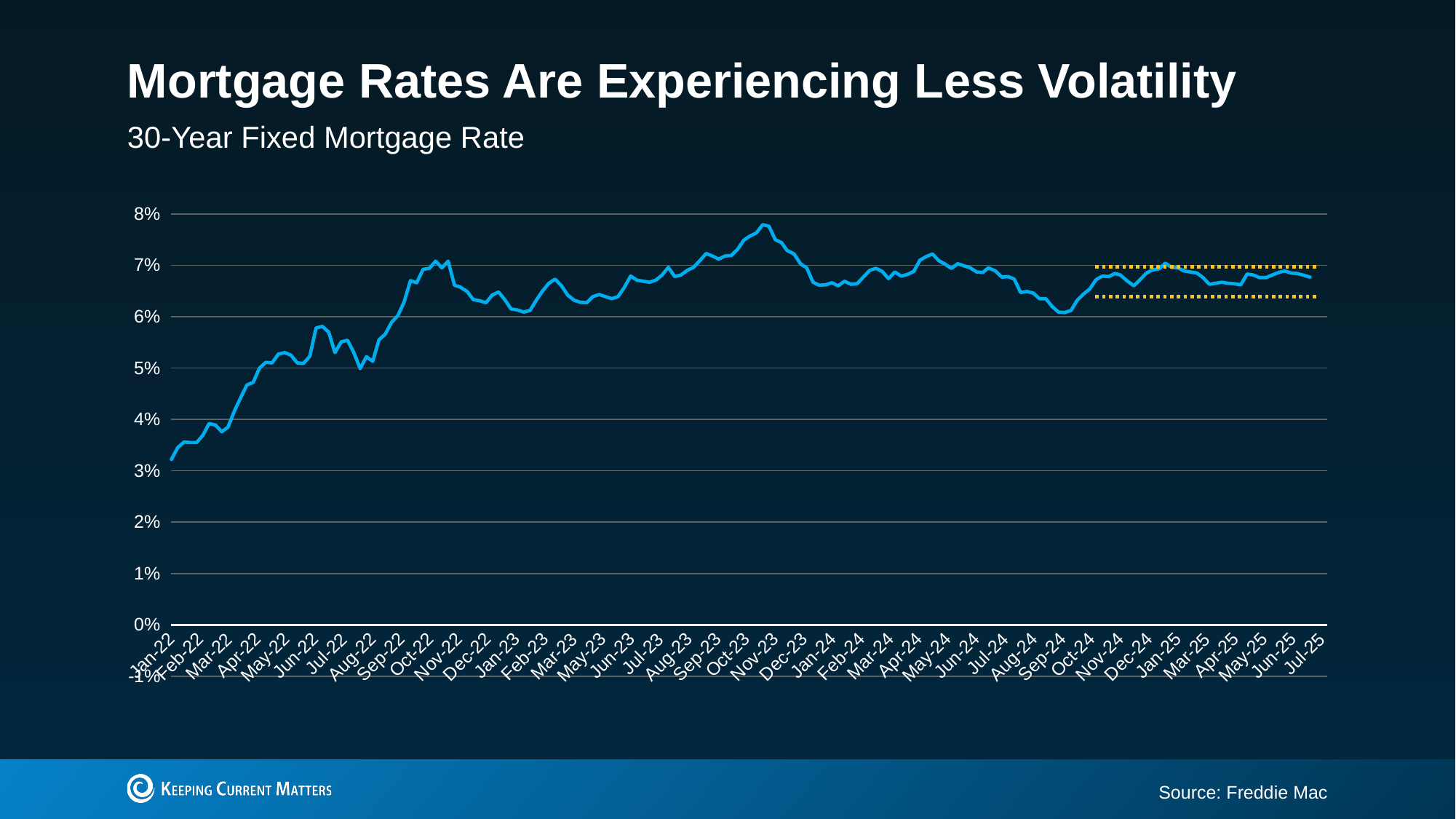
Is the mortgage rate at its Nov-23 peak greater or less than 7%? greater What is the title of the chart? 30-Year Fixed Mortgage Rate Overall, does the mortgage rate rise or fall from Jan-22 to Jul-25? rise What is the source cited for the chart data? Freddie Mac Is the mortgage rate for Jul-25 greater or less than 7%? less Which is higher, the mortgage rate in Jan-22 or in Jul-25? Jul-25 What kind of chart is shown on the slide? line chart Is the mortgage rate for Jun-22 greater or less than 5%? greater In which month does the 30-year fixed mortgage rate reach its highest point on the chart? Oct-23 In which month is the 30-year fixed mortgage rate at its lowest point on the chart? Jan-22